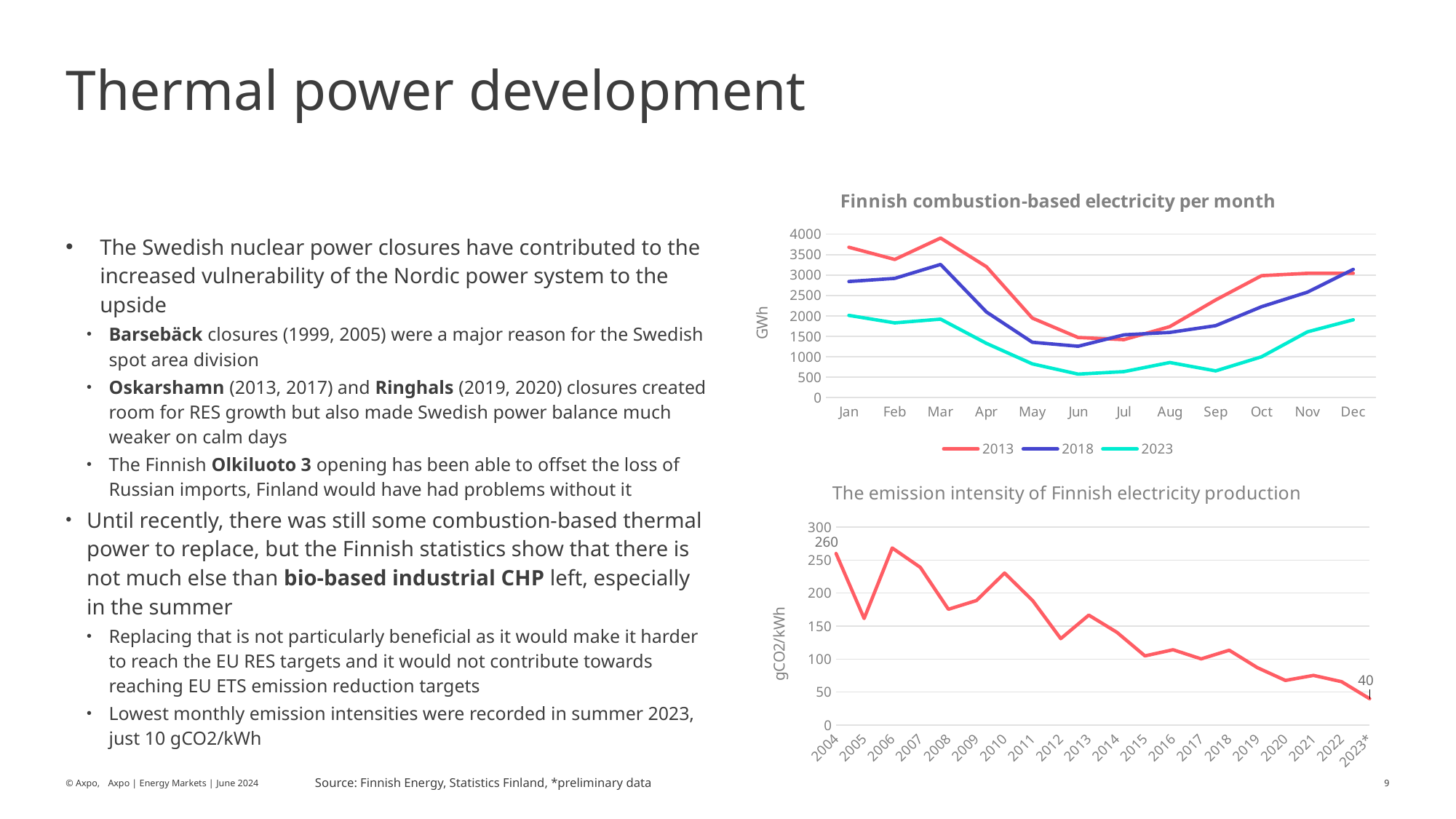
In the 'Finnish combustion-based electricity per month' chart, is the 2013 value for Mar greater or less than 3500? greater In 'The emission intensity of Finnish electricity production' chart, do the values generally rise or fall from 2004 to 2023*? fall In 'The emission intensity of Finnish electricity production' chart, what is the value for 2004? 260 How many months are shown on the x axis of the 'Finnish combustion-based electricity per month' chart? 12 In 'The emission intensity of Finnish electricity production' chart, what is the difference between the 2004 value and the 2023* value? 220 In the 'Finnish combustion-based electricity per month' chart, in which month does the 2013 series reach its highest value? Mar In the 'Finnish combustion-based electricity per month' chart, is the 2023 value for Jun greater or less than 1000? less In the 'Finnish combustion-based electricity per month' chart, which colour is the 2023 series drawn in? cyan In 'The emission intensity of Finnish electricity production' chart, what is the value for 2023*? 40 In the 'Finnish combustion-based electricity per month' chart, which series has the larger value in Jan, 2013 or 2023? 2013 How many series does the legend of the 'Finnish combustion-based electricity per month' chart list? 3 What kind of chart is the 'Finnish combustion-based electricity per month' chart? line chart